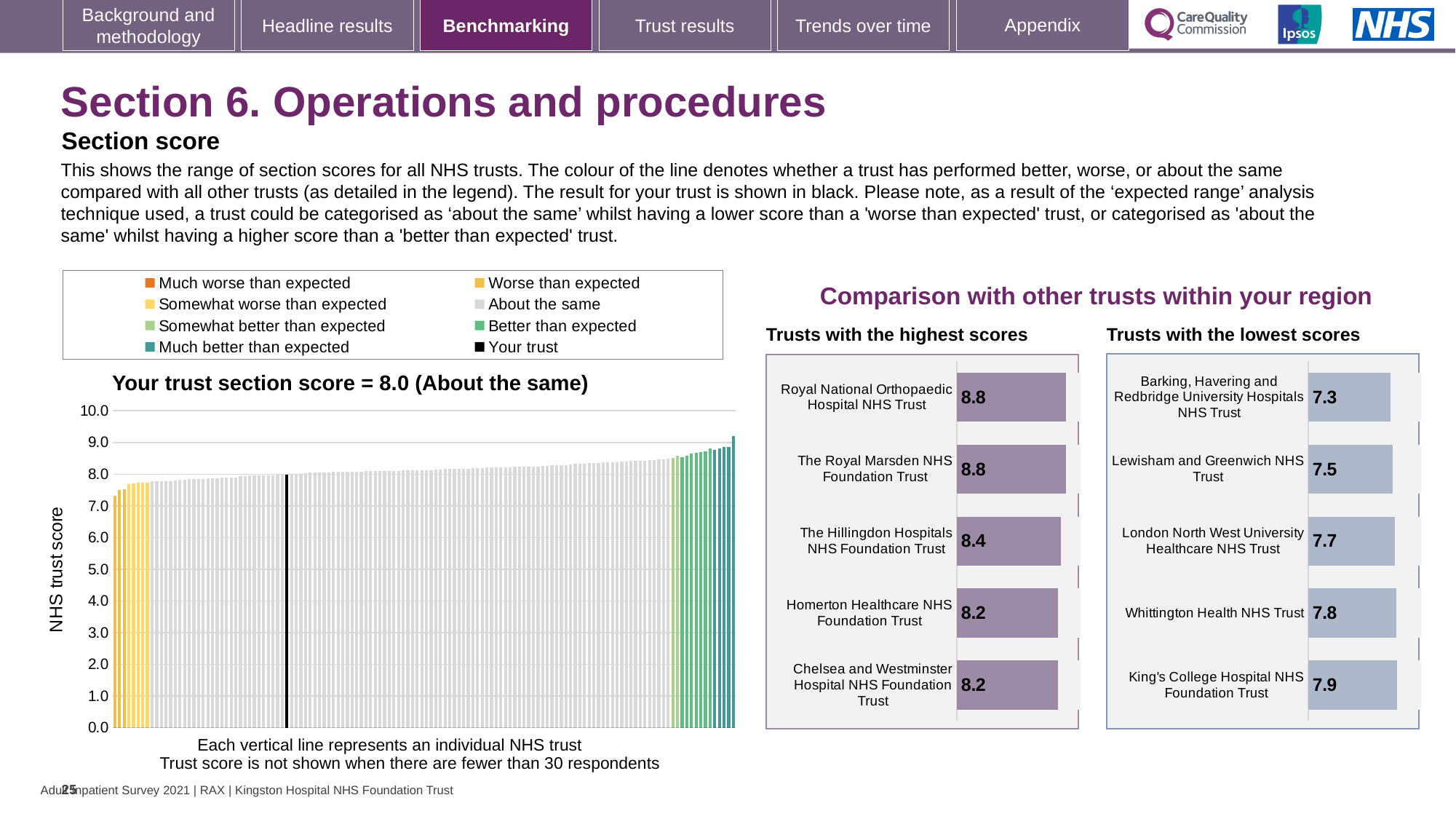
In the 'Trusts with the lowest scores' chart, what is the score for Whittington Health NHS Trust? 7.8 Which is larger: the score for The Hillingdon Hospitals NHS Foundation Trust in the 'Trusts with the highest scores' chart or the score for King's College Hospital NHS Foundation Trust in the 'Trusts with the lowest scores' chart? The Hillingdon Hospitals NHS Foundation Trust How many entries does the legend above the 'Your trust section score' chart list? 8 In the 'Trusts with the highest scores' chart, what is the difference between the score for Royal National Orthopaedic Hospital NHS Trust and the score for Homerton Healthcare NHS Foundation Trust? 0.6 In the 'Your trust section score' chart, do the bars rise or fall from left to right? rise In the 'Trusts with the highest scores' chart, how many trusts are shown? 5 What is the y-axis label of the 'Your trust section score' chart? NHS trust score What kind of chart is the 'Your trust section score' chart? bar chart In the 'Your trust section score' chart, is the value of the leftmost bar greater or less than 8.0? less In the 'Trusts with the lowest scores' chart, which trust has the lowest score? Barking, Havering and Redbridge University Hospitals NHS Trust In the 'Your trust section score' chart, what is the section score for your trust? 8.0 In the 'Trusts with the highest scores' chart, what is the score for The Hillingdon Hospitals NHS Foundation Trust? 8.4